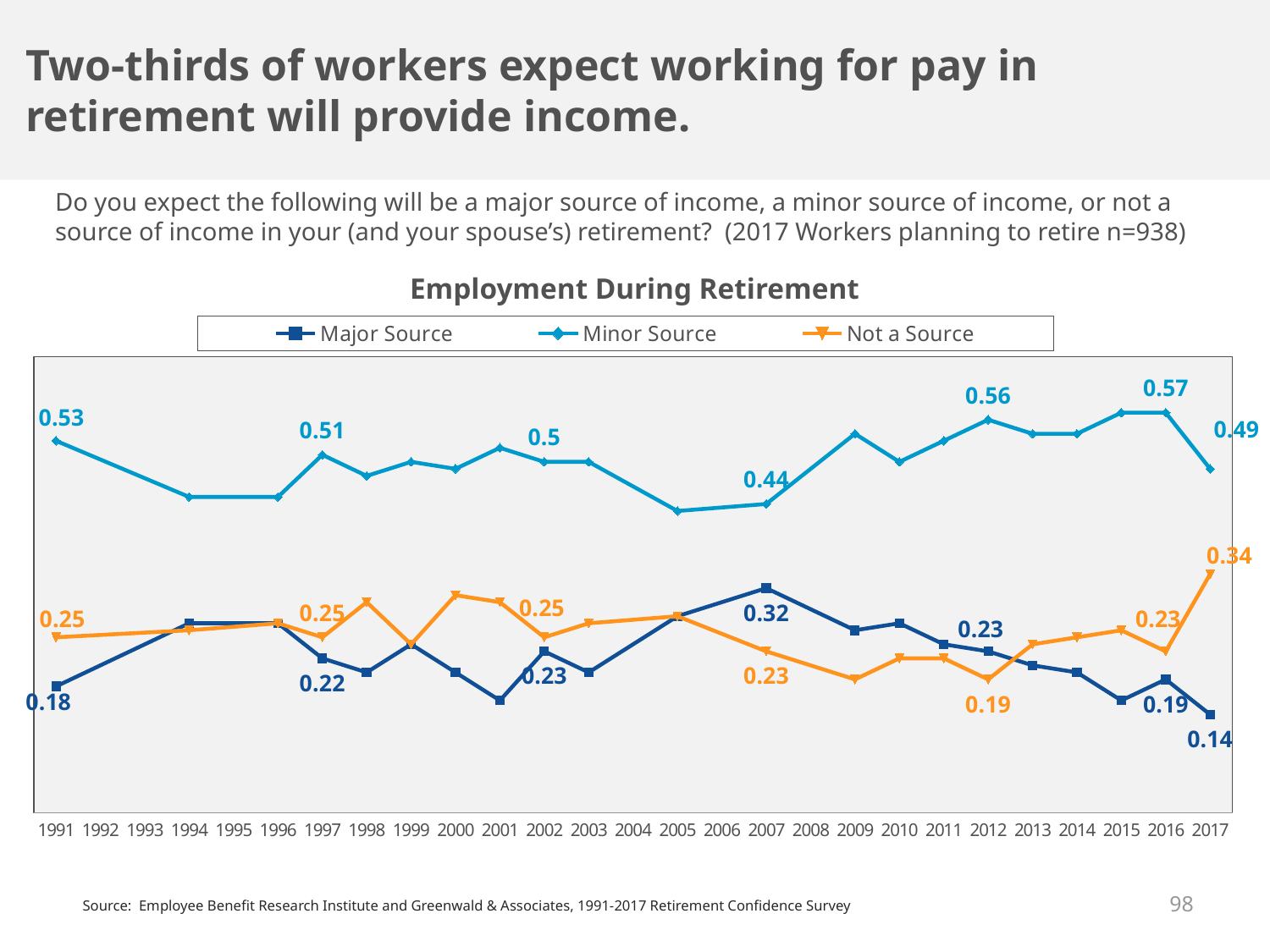
What is the value for Not a Source in 2017? 0.34 What is the value for Minor Source in 2016? 0.57 What kind of chart is shown on the slide? line chart In 2012, which is larger: Major Source or Not a Source? Major Source What is the value for Major Source in 2007? 0.32 What is the value for Minor Source in 2017? 0.49 What is the title of the chart? Employment During Retirement What is the difference between the Minor Source and Major Source values in 2017? 0.35 How many series does the legend list? 3 Which series has the highest value in 2017? Minor Source Does the Major Source line rise or fall from 2007 to 2017? fall What is the value for Major Source in 2017? 0.14